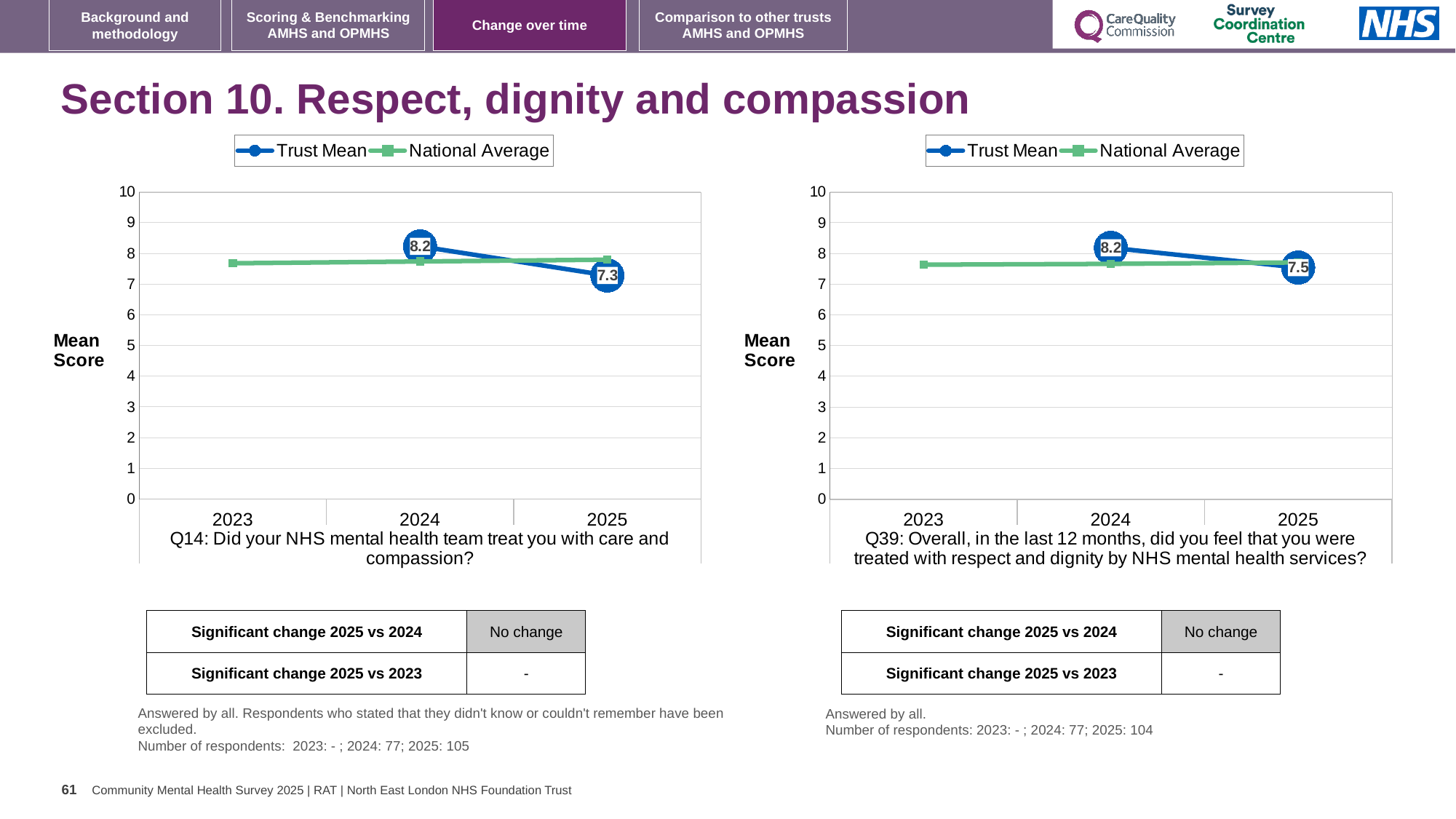
In the Q14 chart (left), does the Trust Mean rise or fall from 2024 to 2025? fall How many series does the legend of the Q14 chart (left) list? 2 In the Q14 chart (left), by how much did the Trust Mean fall from 2024 to 2025? 0.9 How many years are shown on the x axis of the Q39 chart (right)? 3 In the Q39 chart (right), what is the Trust Mean for 2025? 7.5 In the Q14 chart (left), what is the Trust Mean for 2025? 7.3 In the Q14 chart (left), is the National Average for 2023 greater or less than 7? greater In the Q39 chart (right), what is the Trust Mean for 2024? 8.2 In the Q39 chart (right), which is larger, the Trust Mean in 2024 or in 2025? 2024 What kind of chart is the Q39 chart (right)? line chart In the Q14 chart (left), what is the Trust Mean for 2024? 8.2 In the Q39 chart (right), what is the difference between the Trust Mean in 2024 and in 2025? 0.7